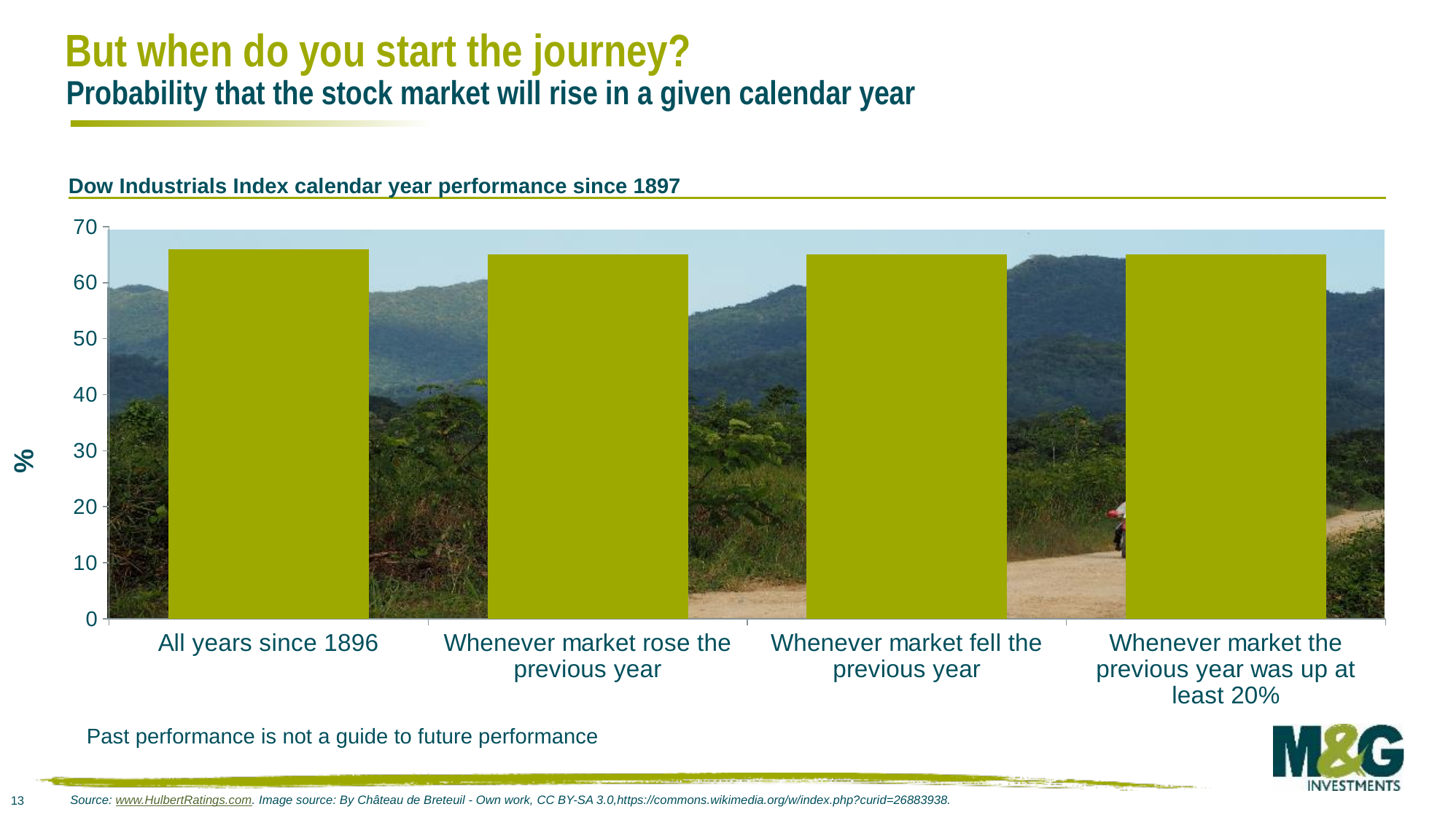
Is the value for "All years since 1896" greater or less than 60? greater What kind of chart is shown on the slide? bar chart How many categories are plotted on the chart? 4 What label is shown on the vertical axis of the chart? % Is the value for "Whenever market rose the previous year" greater or less than 40? greater What is the highest value shown on the vertical axis of the chart? 70 Is the value for "All years since 1896" greater or less than 70? less What is the title of the chart? Dow Industrials Index calendar year performance since 1897